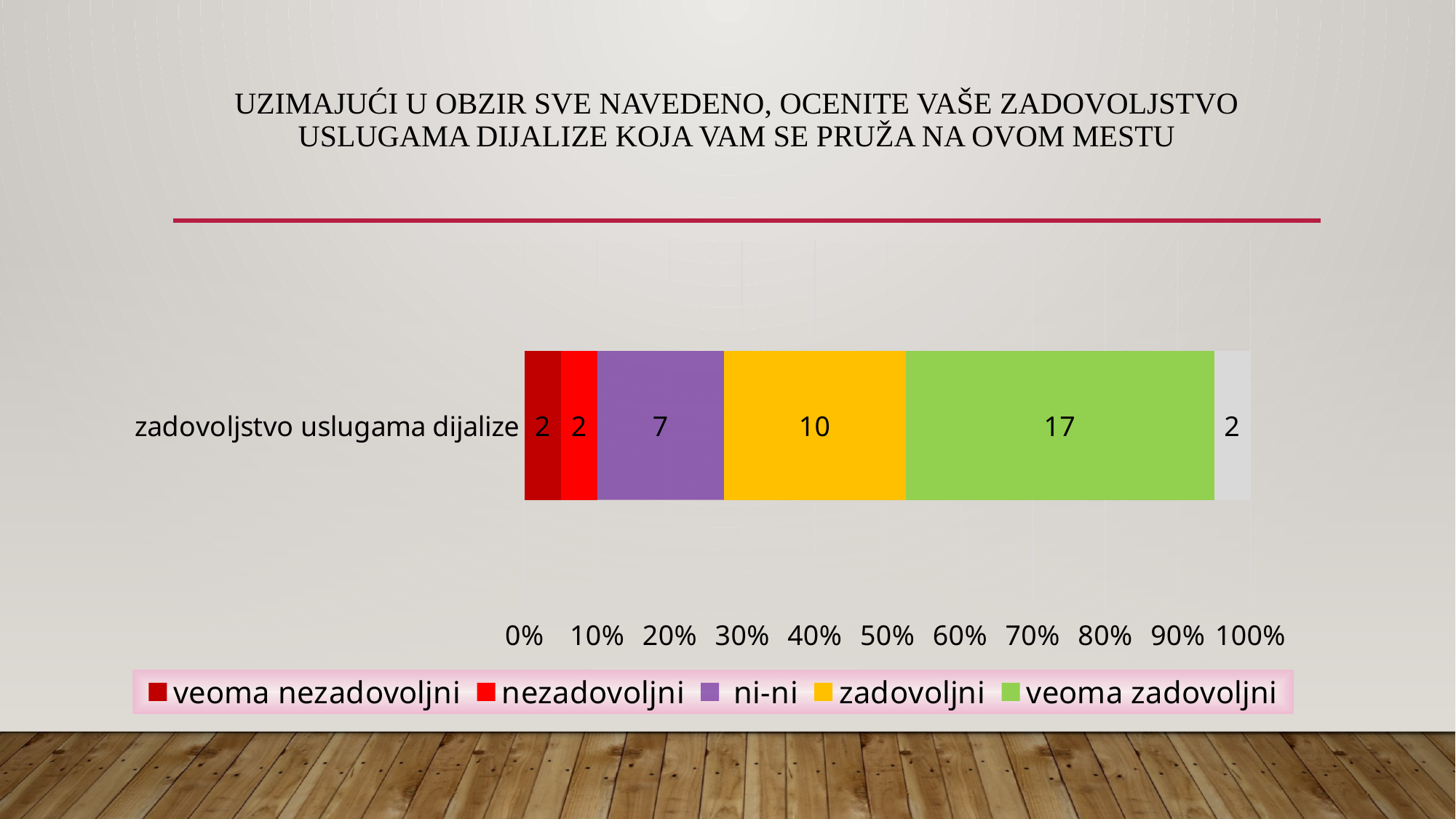
What is the value for 'ni-ni' in the bar? 7 Which is larger, the value for 'ni-ni' or the value for 'zadovoljni'? zadovoljni How many series does the legend list? 5 What is the difference between the values for 'veoma zadovoljni' and 'zadovoljni'? 7 Which legend series has the largest value in the bar? veoma zadovoljni What is the value for 'veoma zadovoljni' in the bar? 17 What kind of chart is shown on the slide? stacked bar chart What is the value for 'zadovoljni' in the bar? 10 What is the sum of all the values printed on the bar segments? 40 What is the value for 'nezadovoljni' in the bar? 2 How many categories are plotted on the vertical axis? 1 What is the difference between the values for 'zadovoljni' and 'ni-ni'? 3